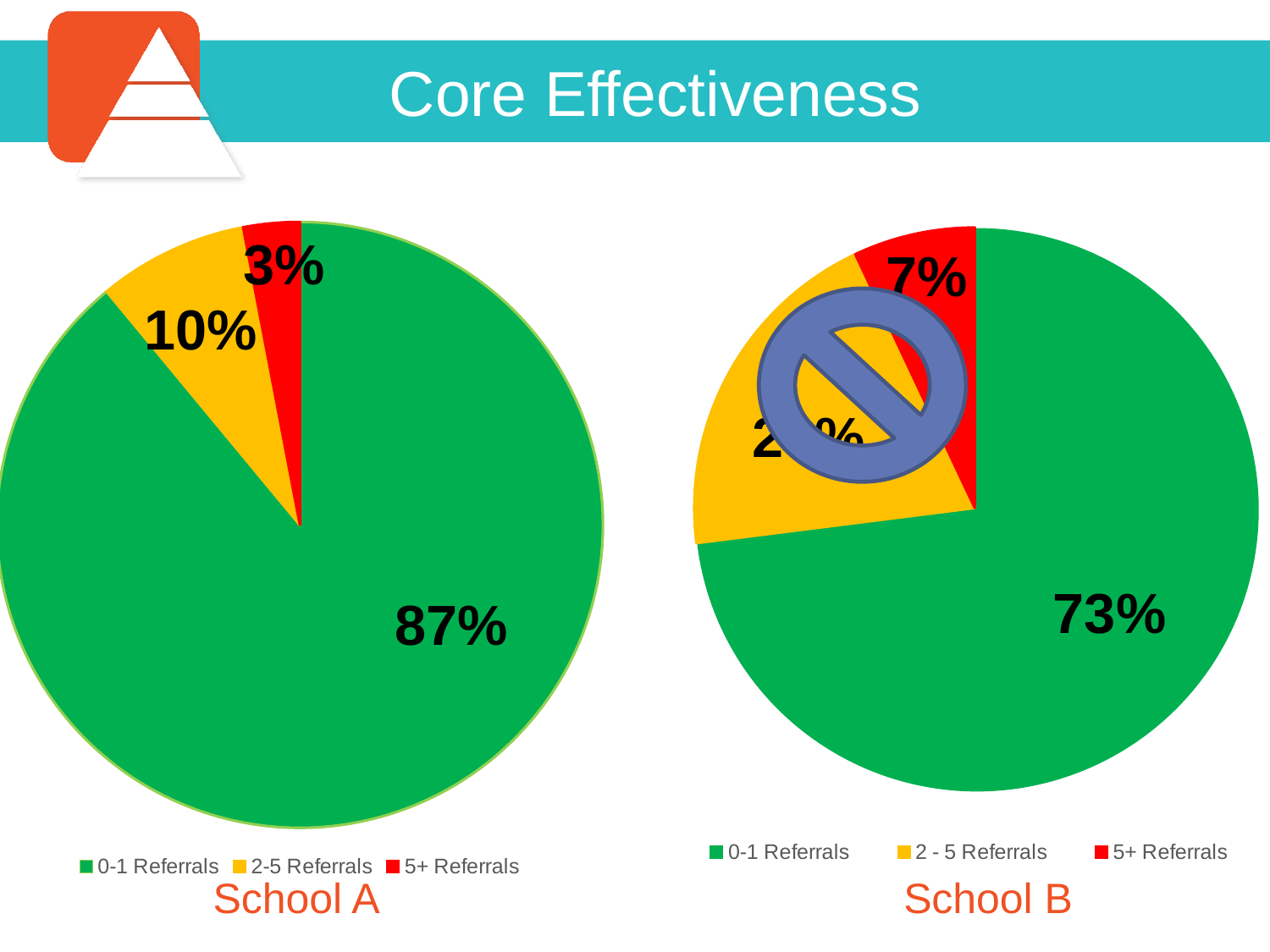
In the School A chart, what percentage is shown for 2-5 Referrals? 10% What is the difference between the 0-1 Referrals share in School A and in School B? 14% In the School A chart, which category has the smallest slice? 5+ Referrals In the School A chart, what percentage is shown for 5+ Referrals? 3% In the School B chart, which category has the largest slice? 0-1 Referrals In the School B chart, what percentage is shown for 0-1 Referrals? 73% In the School A chart, which category has the largest slice? 0-1 Referrals In the School B chart, what percentage is shown for 5+ Referrals? 7% In the School A chart, what percentage is shown for 0-1 Referrals? 87% Which school has the larger 5+ Referrals share, School A or School B? School B How many categories does the legend of the School B chart list? 3 What kind of chart is used for School A? Pie chart